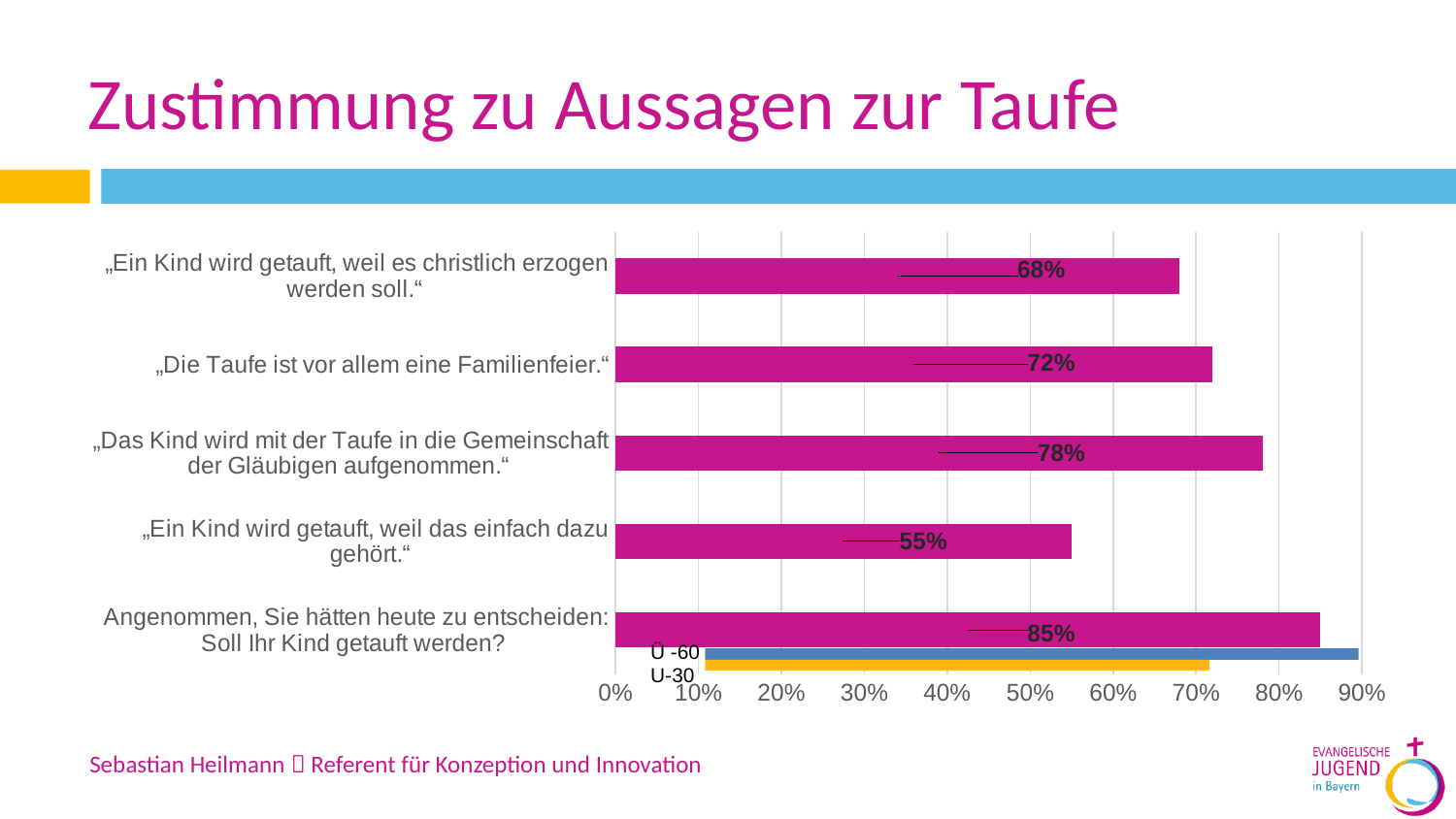
What is the value for "Ein Kind wird getauft, weil es christlich erzogen werden soll."? 68% What is the value for "Die Taufe ist vor allem eine Familienfeier."? 72% Which statement has the highest value? Angenommen, Sie hätten heute zu entscheiden: Soll Ihr Kind getauft werden? What is the difference between the value for "Das Kind wird mit der Taufe in die Gemeinschaft der Gläubigen aufgenommen." and the value for "Ein Kind wird getauft, weil das einfach dazu gehört."? 23% What is the value for "Ein Kind wird getauft, weil das einfach dazu gehört."? 55% Which statement has the lowest value? "Ein Kind wird getauft, weil das einfach dazu gehört." What is the value for "Das Kind wird mit der Taufe in die Gemeinschaft der Gläubigen aufgenommen."? 78% How many statements (categories) are shown on the chart? 5 Which is larger: the value for "Die Taufe ist vor allem eine Familienfeier." or the value for "Ein Kind wird getauft, weil es christlich erzogen werden soll."? "Die Taufe ist vor allem eine Familienfeier." What kind of chart is shown on the slide? bar chart Is the value for "Ein Kind wird getauft, weil das einfach dazu gehört." greater or less than 60%? less What is the title of the slide? Zustimmung zu Aussagen zur Taufe